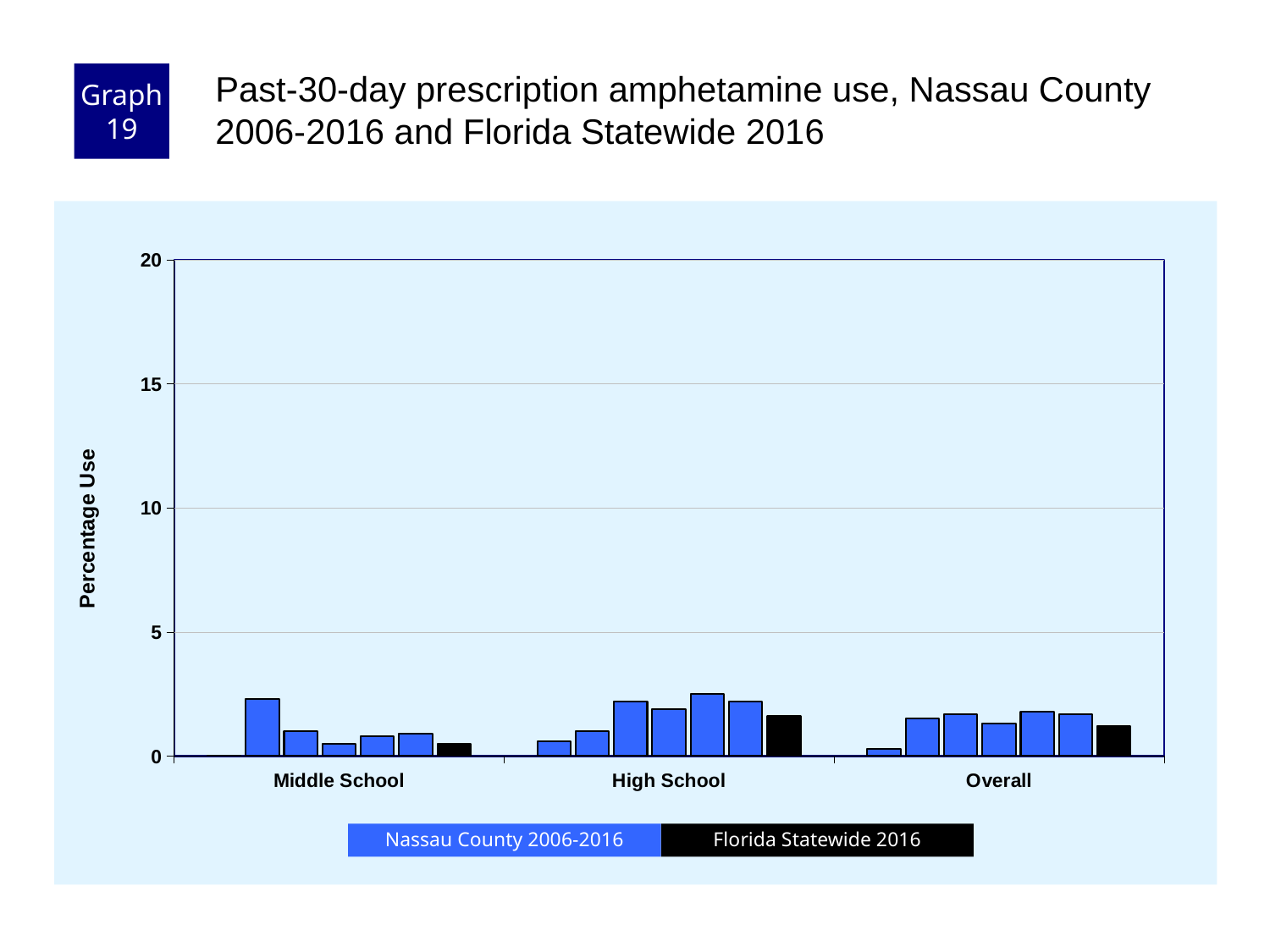
What is the label on the y axis? Percentage Use How many series does the legend list? 2 Is the Florida Statewide 2016 value for Middle School greater or less than 5? less Are any of the Nassau County 2006-2016 bars greater than 5? No Is the Florida Statewide 2016 value for High School greater or less than 5? less Which is larger, the Florida Statewide 2016 value for High School or for Middle School? High School Which category has the lowest Florida Statewide 2016 value? Middle School How many school-level categories are shown on the x axis? 3 Which category has the highest Florida Statewide 2016 value? High School What kind of chart is shown on the slide? bar chart What is the title of the chart? Past-30-day prescription amphetamine use, Nassau County 2006-2016 and Florida Statewide 2016